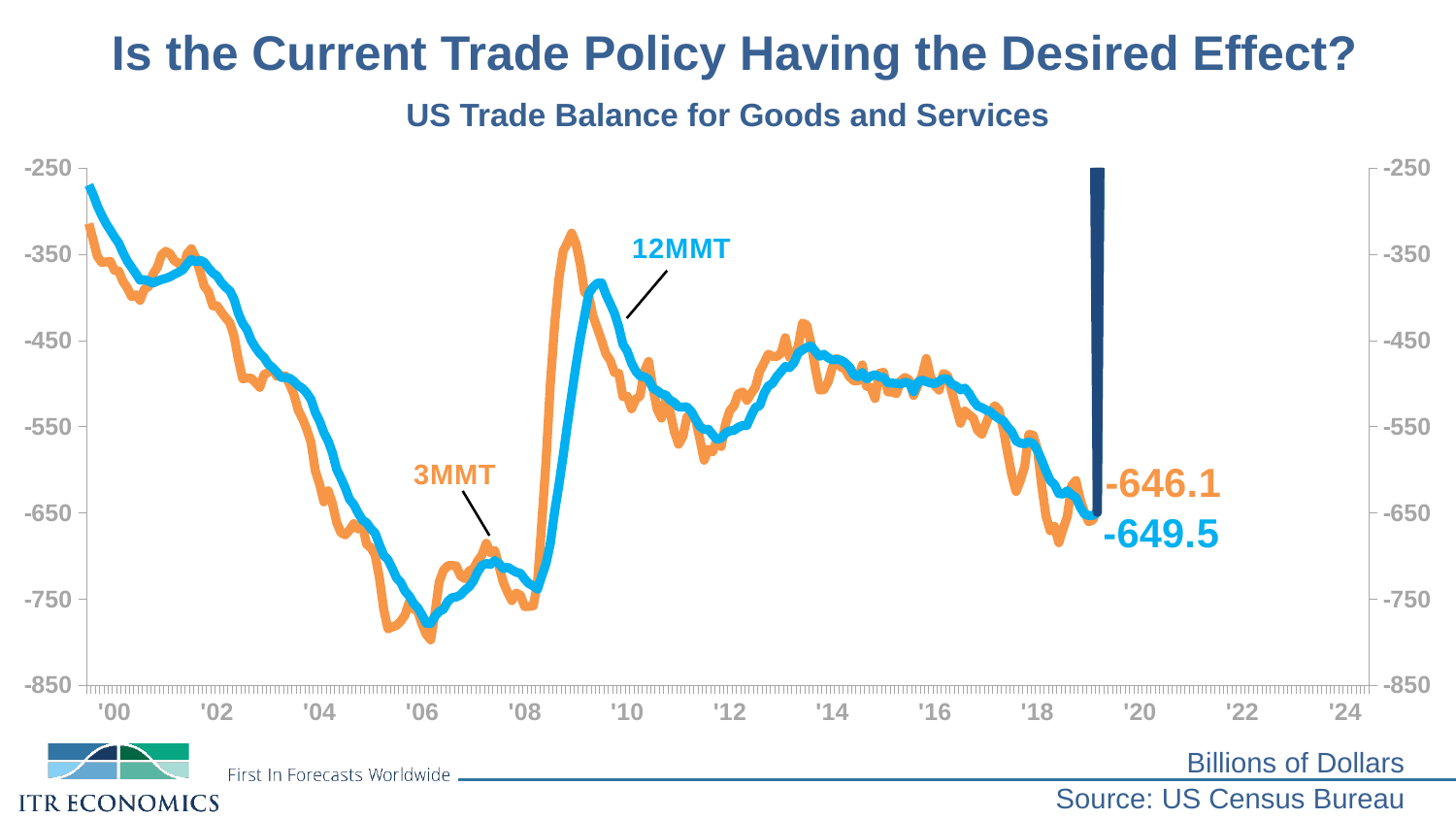
Is the lowest point of the 12MMT line around '06 greater or less than -750? less Which series has the higher (less negative) latest value, 3MMT or 12MMT? 3MMT What is the difference between the latest 3MMT value (-646.1) and the latest 12MMT value (-649.5)? 3.4 Does the 12MMT line rise or fall between '14 and '18? fall In what units are the values on the chart expressed? Billions of Dollars Is the peak of the 12MMT line around '09 greater or less than -450? greater What is the latest value shown for the 3MMT series? -646.1 What type of chart is shown on the slide? line chart What is the title of the chart? US Trade Balance for Goods and Services How many year labels are shown on the x axis? 13 What is the latest value shown for the 12MMT series? -649.5 How many data series are labeled on the chart? 2